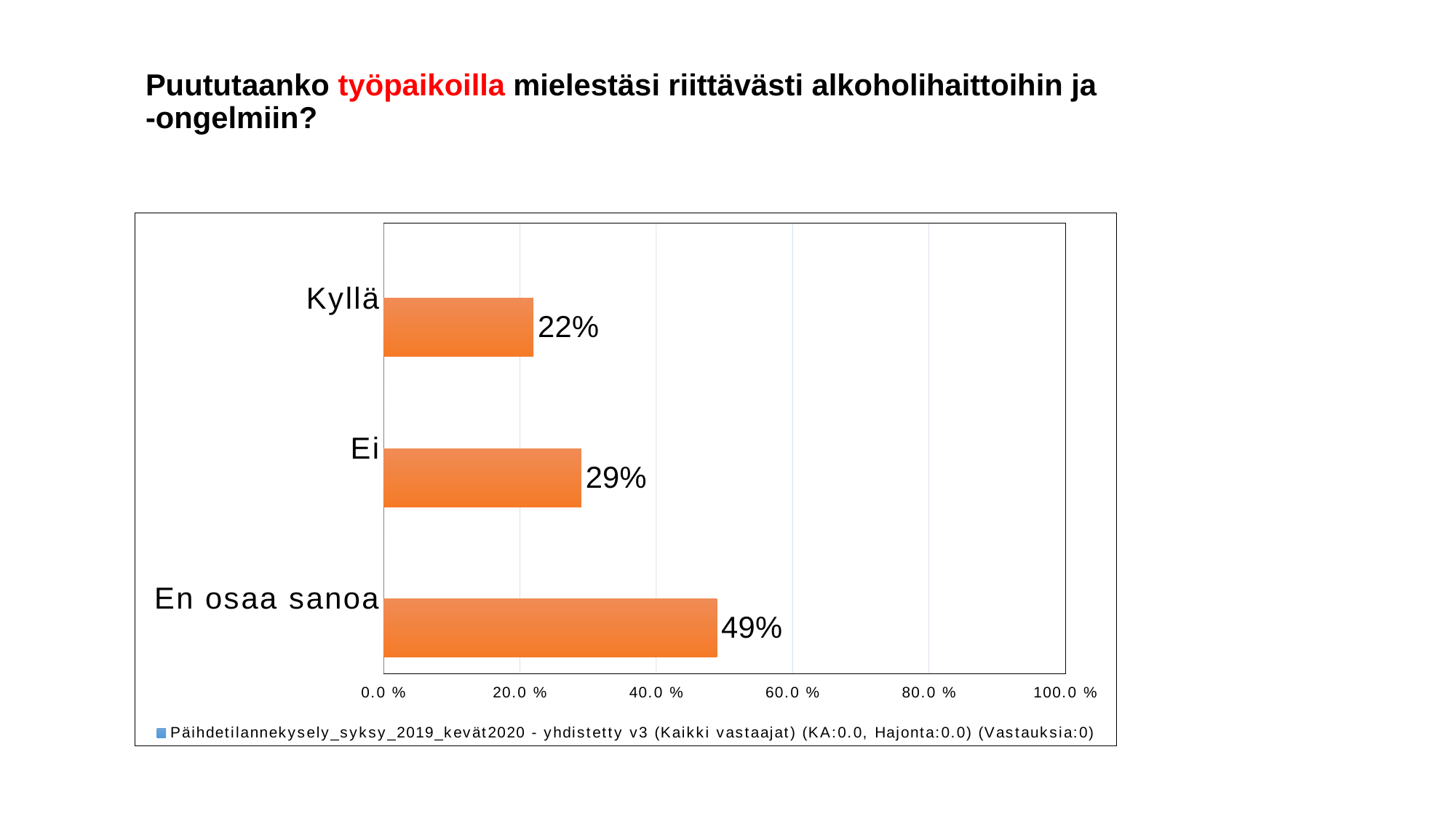
Which category has the highest value? En osaa sanoa What is the difference between the values for Ei and Kyllä? 7% What is the value for Kyllä? 22% What is the value for Ei? 29% What is the difference between the values for En osaa sanoa and Ei? 20% What is the highest value shown on the x axis? 100.0 % Which category has the lowest value? Kyllä Which is larger, the value for Kyllä or the value for Ei? Ei Is the value for En osaa sanoa greater or less than 40.0 %? greater What is the value for En osaa sanoa? 49% What kind of chart is shown on the slide? bar chart How many categories are shown in the chart? 3